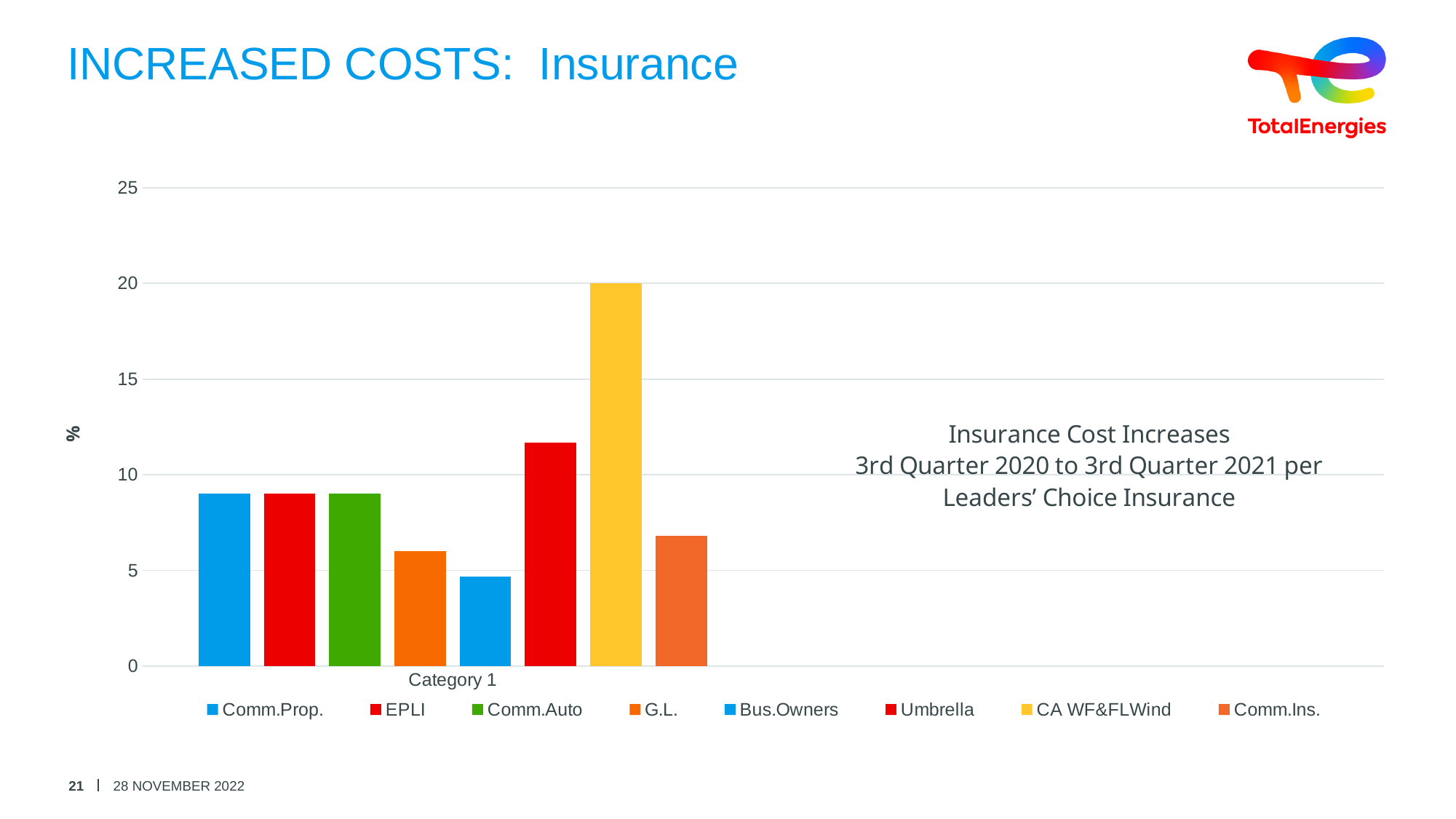
What kind of chart is shown on the slide? bar chart What is the value for CA WF&FLWind? 20 How many categories are shown on the x axis? 1 Which series has the lowest value? Bus.Owners Is the value for Bus.Owners greater or less than 5? less Is the value for Umbrella greater or less than 10? greater How many series does the legend list? 8 Which series has the highest value? CA WF&FLWind What is the label on the y axis? % What is the label of the category on the x axis? Category 1 Which is larger, the value for Umbrella or the value for G.L.? Umbrella Is the value for Comm.Prop. greater or less than 10? less